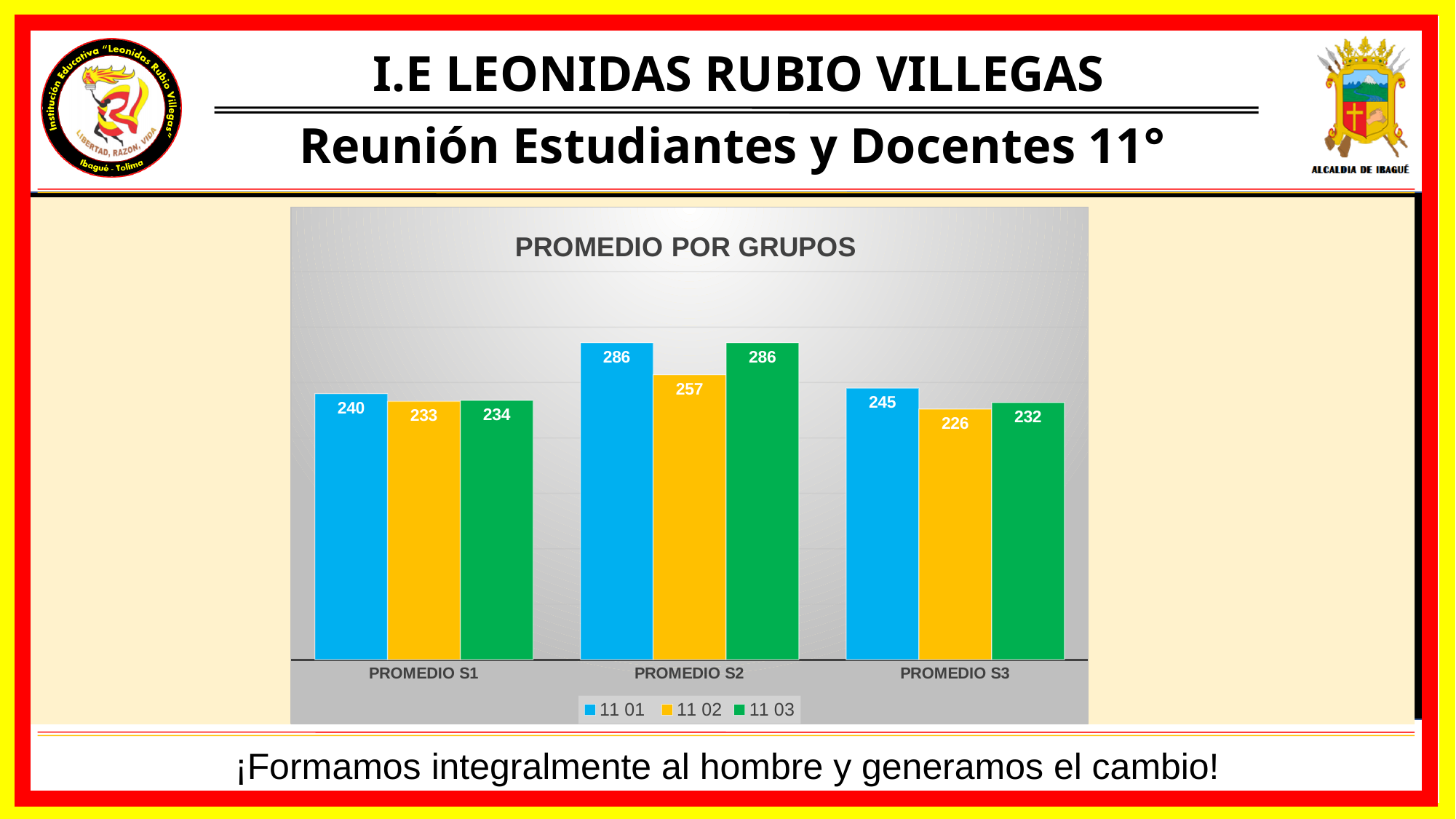
What is the value for 11 01 at PROMEDIO S1? 240 What kind of chart is shown? Bar chart How many categories are shown on the x axis? 3 Which category has the lowest value for 11 02? PROMEDIO S3 What is the value for 11 02 at PROMEDIO S2? 257 What is the difference between the 11 01 and 11 02 values at PROMEDIO S2? 29 How many series does the legend list? 3 Which is larger at PROMEDIO S3: the value for 11 01 or the value for 11 02? 11 01 What is the title of the chart? PROMEDIO POR GRUPOS Which category has the highest value for 11 01? PROMEDIO S2 What is the value for 11 02 at PROMEDIO S3? 226 What is the value for 11 03 at PROMEDIO S3? 232